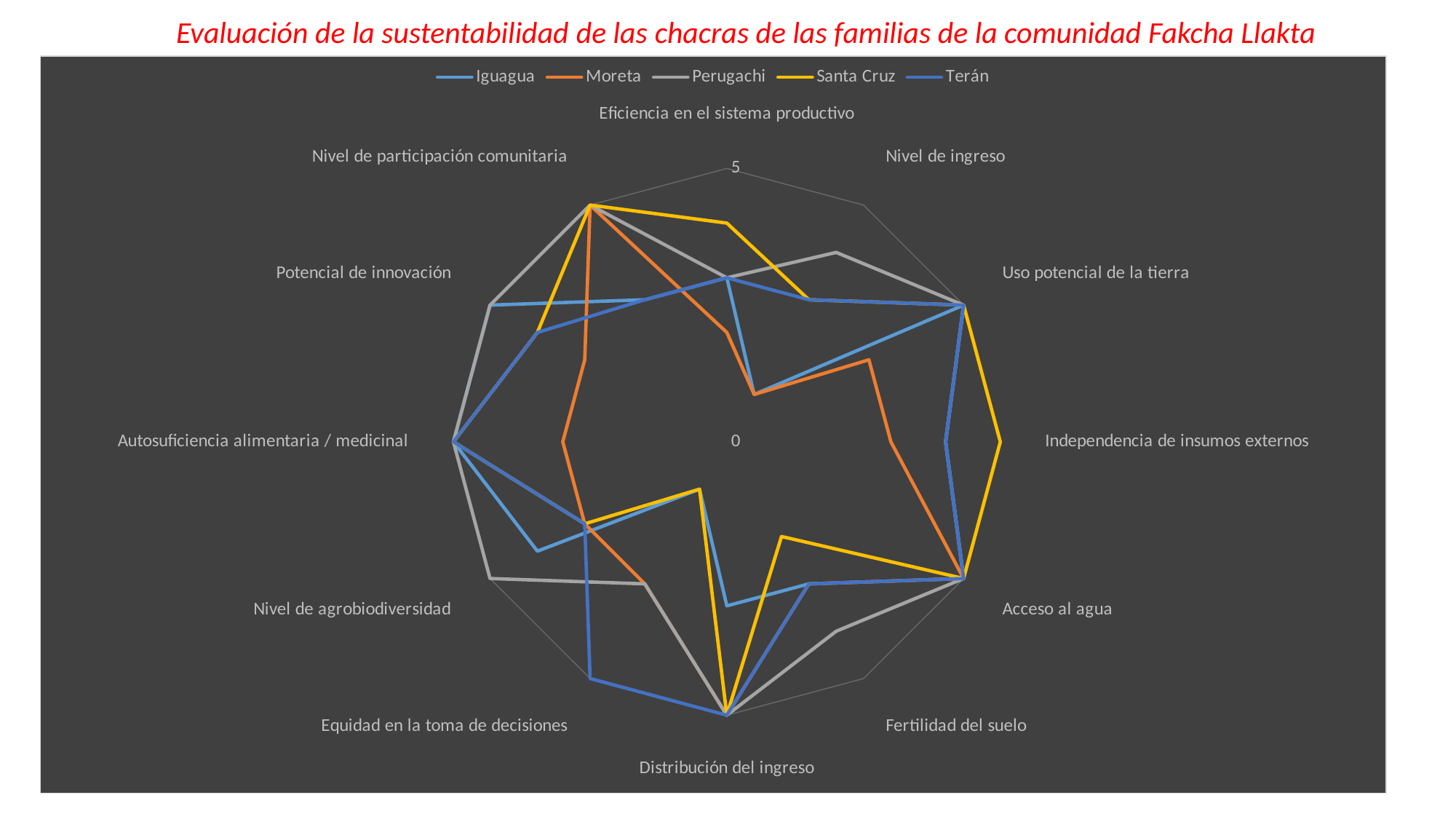
Which series has the highest value for Eficiencia en el sistema productivo? Santa Cruz Which series has the highest value for Nivel de agrobiodiversidad? Perugachi Which series has the lowest value for Eficiencia en el sistema productivo? Moreta Which series has the lowest value for Distribución del ingreso? Iguagua Which series has the highest value for Equidad en la toma de decisiones? Terán How many series does the legend list? 5 Is the value for Moreta at Autosuficiencia alimentaria / medicinal greater or less than 5? less Which series are listed in the legend? Iguagua, Moreta, Perugachi, Santa Cruz, Terán What is the title of the chart? Evaluación de la sustentabilidad de las chacras de las familias de la comunidad Fakcha Llakta What kind of chart is shown on the slide? Radar chart How many categories (axes) does the radar chart have? 12 For Independencia de insumos externos, which is larger: Santa Cruz or Moreta? Santa Cruz